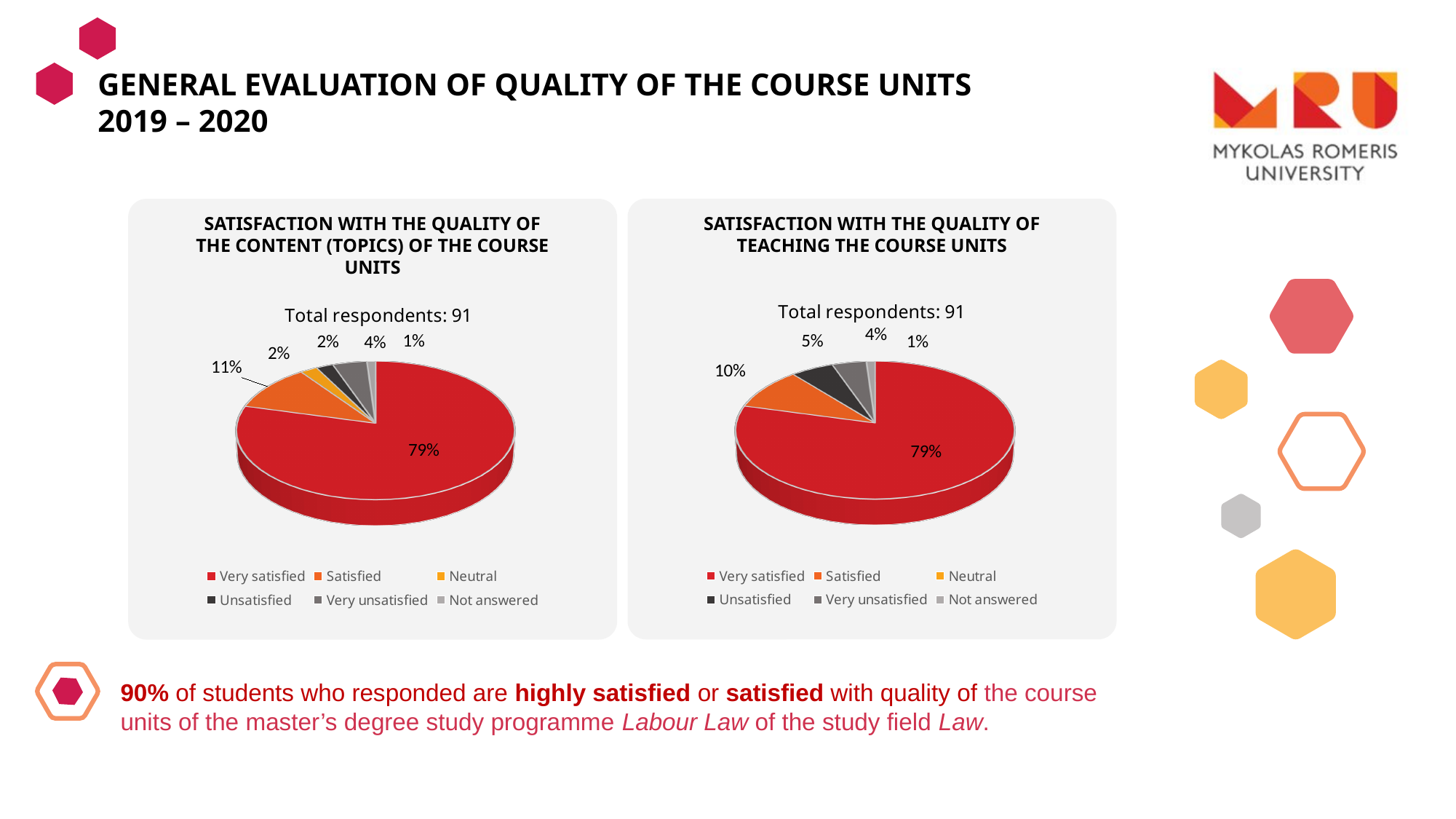
How many categories does the legend of the chart 'Satisfaction with the quality of the content (topics) of the course units' list? 6 In the chart 'Satisfaction with the quality of the content (topics) of the course units', what is the difference between the very satisfied and satisfied shares? 68% In the chart 'Satisfaction with the quality of teaching the course units', which category has the largest share? Very satisfied In the chart 'Satisfaction with the quality of the content (topics) of the course units', what share of respondents were satisfied? 11% How many total respondents are reported for the chart 'Satisfaction with the quality of teaching the course units'? 91 In the chart 'Satisfaction with the quality of teaching the course units', what share of respondents were unsatisfied? 5% In the chart 'Satisfaction with the quality of teaching the course units', what share of respondents were satisfied? 10% In the chart 'Satisfaction with the quality of teaching the course units', which is larger: the satisfied share or the unsatisfied share? Satisfied In the chart 'Satisfaction with the quality of the content (topics) of the course units', which category has the smallest share? Not answered In the chart 'Satisfaction with the quality of the content (topics) of the course units', what share of respondents were very unsatisfied? 4% What type of chart is used in 'Satisfaction with the quality of teaching the course units'? Pie chart In the chart 'Satisfaction with the quality of the content (topics) of the course units', what share of respondents were very satisfied? 79%